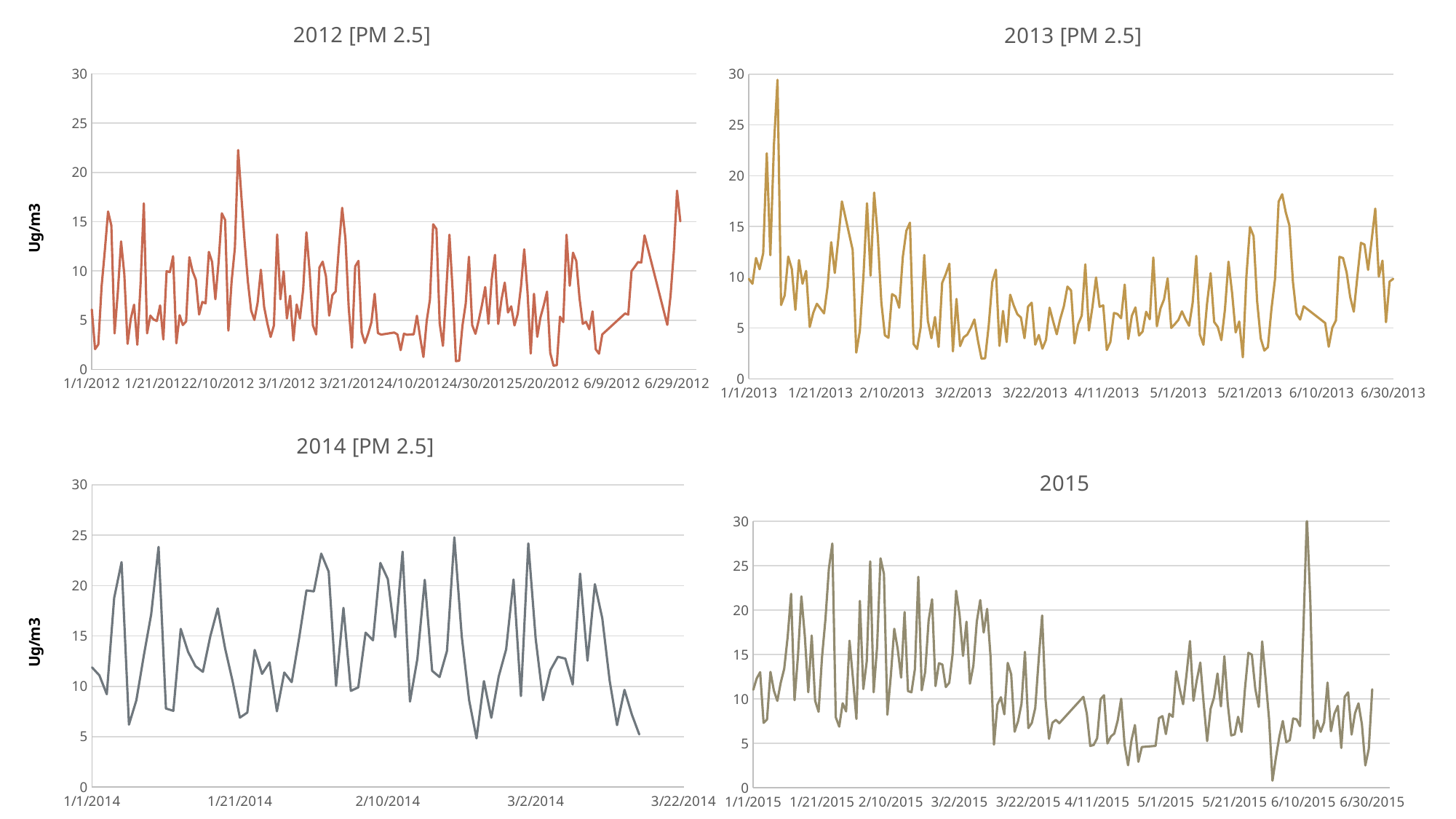
On the 2015 chart, is the value at 6/30/2015 greater or less than 15? less What is the title of the bottom-right chart? 2015 On the 2012 [PM 2.5] chart, is the lowest value near 5/20/2012 greater or less than 5? less On the 2013 [PM 2.5] chart, is the highest peak in early January greater or less than 25? greater What kind of chart is the 2012 [PM 2.5] chart? line chart What is the y-axis label on the 2014 [PM 2.5] chart? Ug/m3 How many charts are shown on the slide? 4